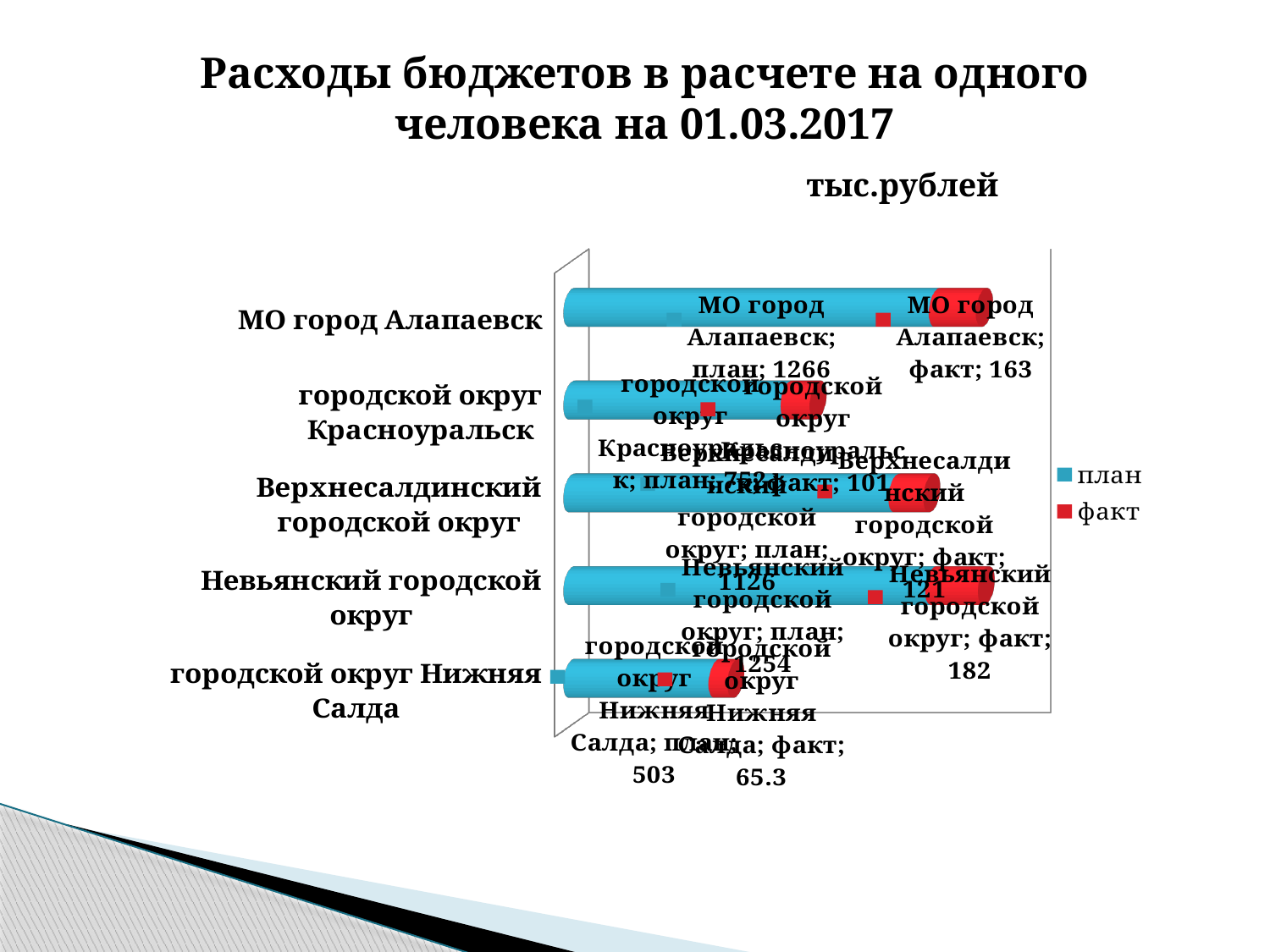
Which category has the highest факт value? Невьянский городской округ What is the план value for городской округ Нижняя Салда? 503 What is the план value for Невьянский городской округ? 1254 Which has the larger факт value: Невьянский городской округ or МО город Алапаевск? Невьянский городской округ Which category has the lowest план value? городской округ Нижняя Салда What is the факт value for МО город Алапаевск? 163 How many series does the legend list? 2 What is the факт value for городской округ Нижняя Салда? 65.3 What is the difference between the план and факт values for МО город Алапаевск? 1103 What is the факт value for Верхнесалдинский городской округ? 121 How many categories are shown in the chart? 5 What is the план value for МО город Алапаевск? 1266